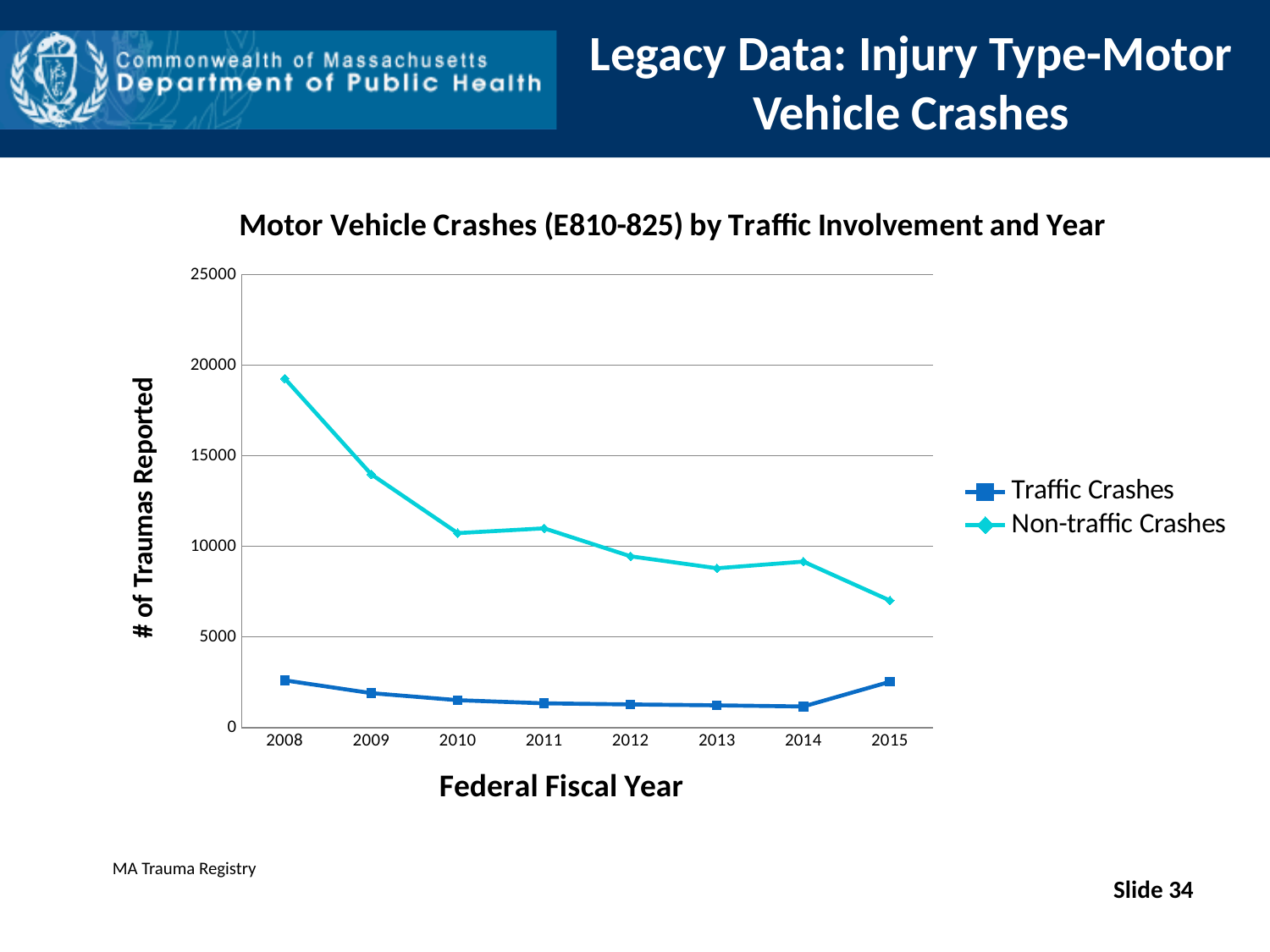
What is the label of the x axis? Federal Fiscal Year In which year is the Non-traffic Crashes value lowest? 2015 Is the Traffic Crashes value for 2012 greater or less than 5000? less In which year is the Non-traffic Crashes value highest? 2008 Is the Non-traffic Crashes value for 2015 greater or less than 10000? less How many series does the legend list? 2 Which series has the larger value in 2010, Traffic Crashes or Non-traffic Crashes? Non-traffic Crashes Is the Non-traffic Crashes value for 2008 greater or less than 15000? greater What kind of chart is shown on the slide? Line chart What is the title of the chart? Motor Vehicle Crashes (E810-825) by Traffic Involvement and Year How many years are plotted along the x axis? 8 Do the Non-traffic Crashes values generally rise or fall from 2008 to 2015? Fall